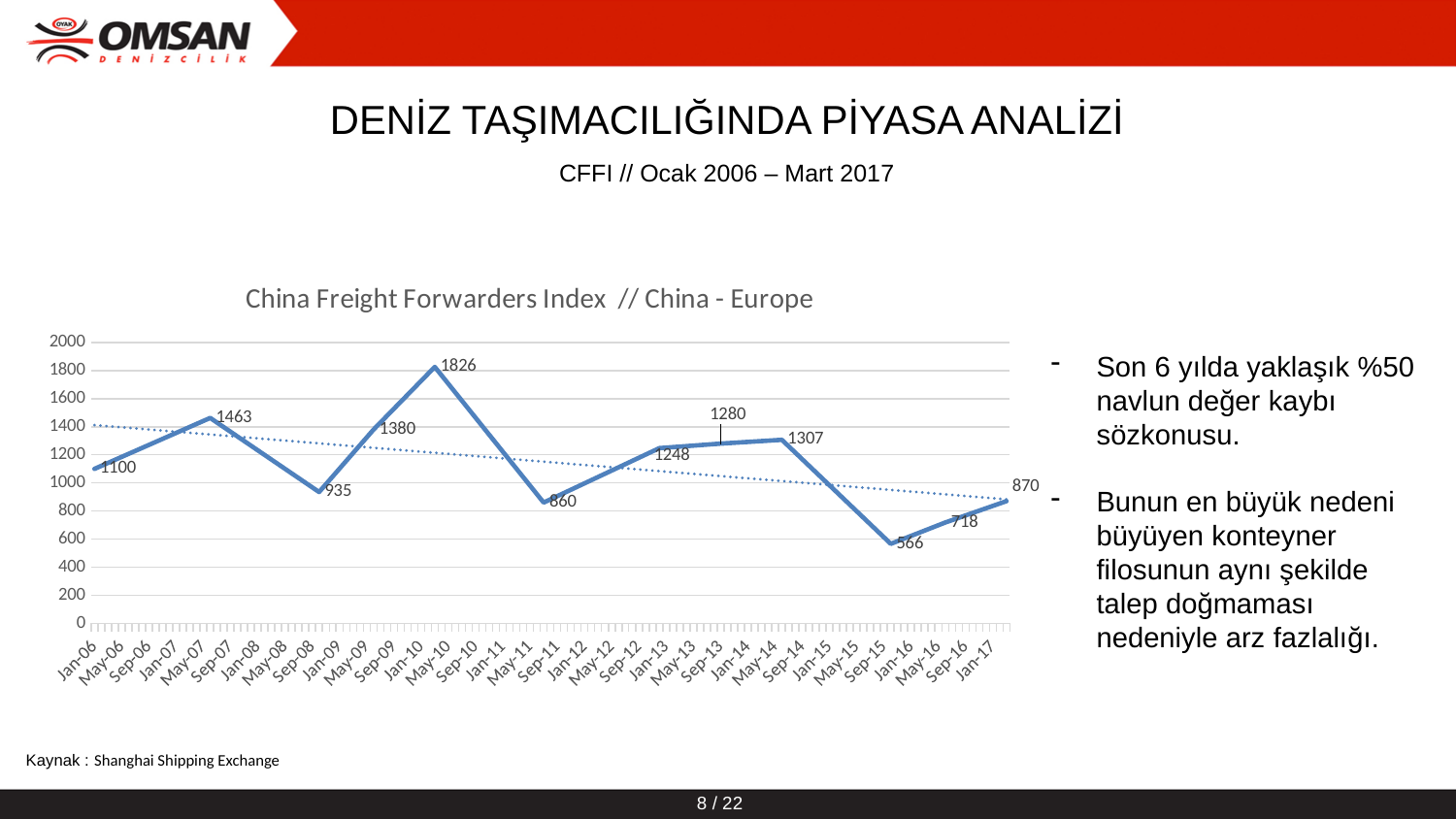
Which is larger, the labelled value 1463 or the labelled value 1380? 1463 What is the maximum value shown on the y axis? 2000 What is the difference between the highest labelled value (1826) and the lowest labelled value (566)? 1260 How many data labels are printed on the line? 12 What type of chart is shown on the slide? Line chart Does the dotted trend line rise or fall from left to right across the x axis? Fall What is the title of the chart? China Freight Forwarders Index // China - Europe What is the value of the first labelled point on the line (at Jan-06)? 1100 What is the highest data-labelled value on the line? 1826 What is the value of the last labelled point on the line (at Jan-17)? 870 What is the lowest data-labelled value on the line? 566 What is the difference between the first labelled value (1100) and the last labelled value (870)? 230